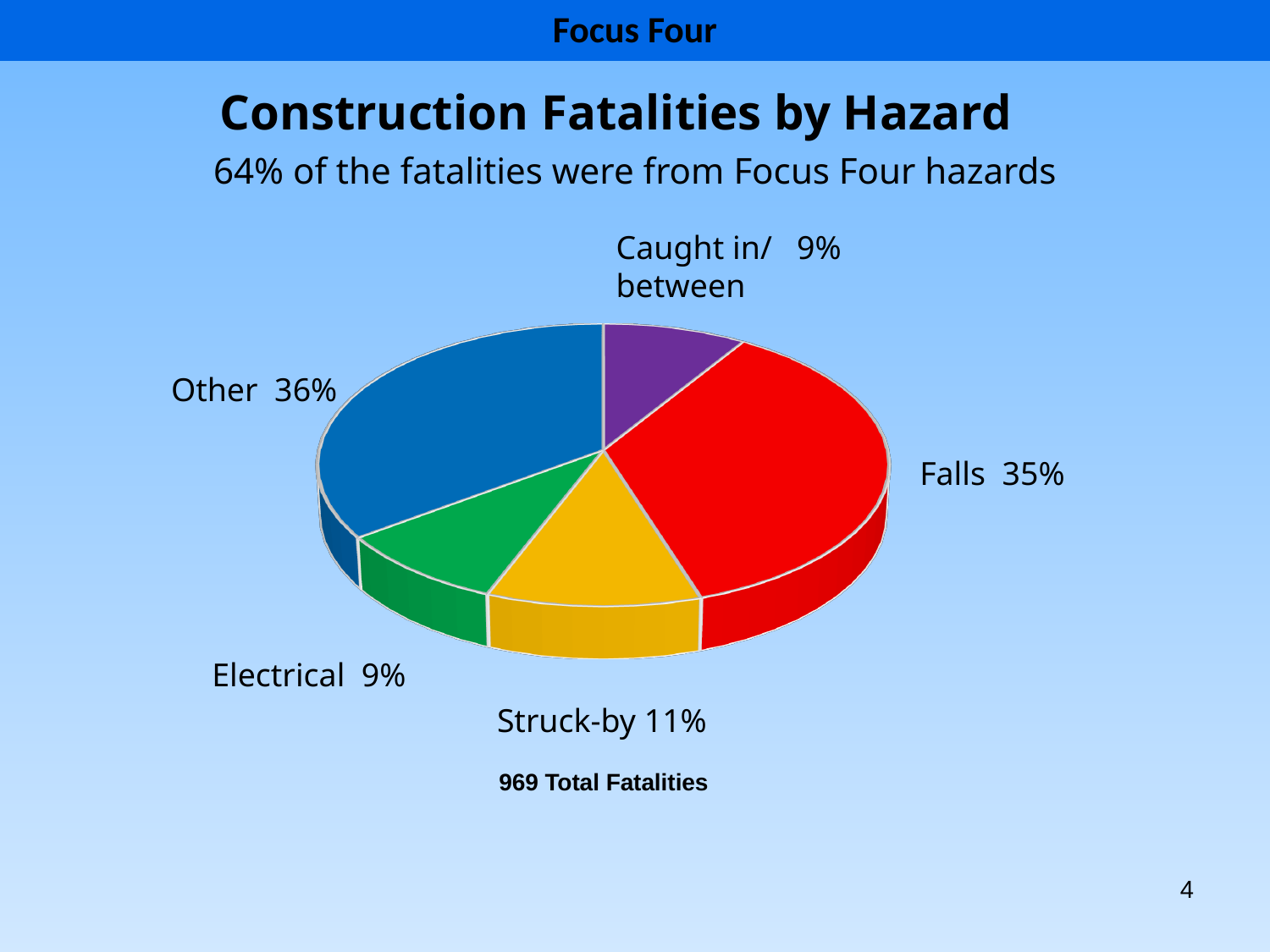
What is the difference in percentage points between Falls and Struck-by? 24 Which hazard category has the largest share of the pie? Other How many slices does the pie chart have? 5 What percentage of construction fatalities were Caught in/between? 9% Which is larger, the share for Struck-by or the share for Electrical? Struck-by What percentage of construction fatalities were Struck-by? 11% What percentage of construction fatalities were Electrical? 9% What type of chart is shown on the slide? pie chart What percentage of construction fatalities were from Falls? 35% What is the title of the chart? Construction Fatalities by Hazard What is the total number of fatalities stated below the chart? 969 Total Fatalities What share of the pie is labelled Other? 36%